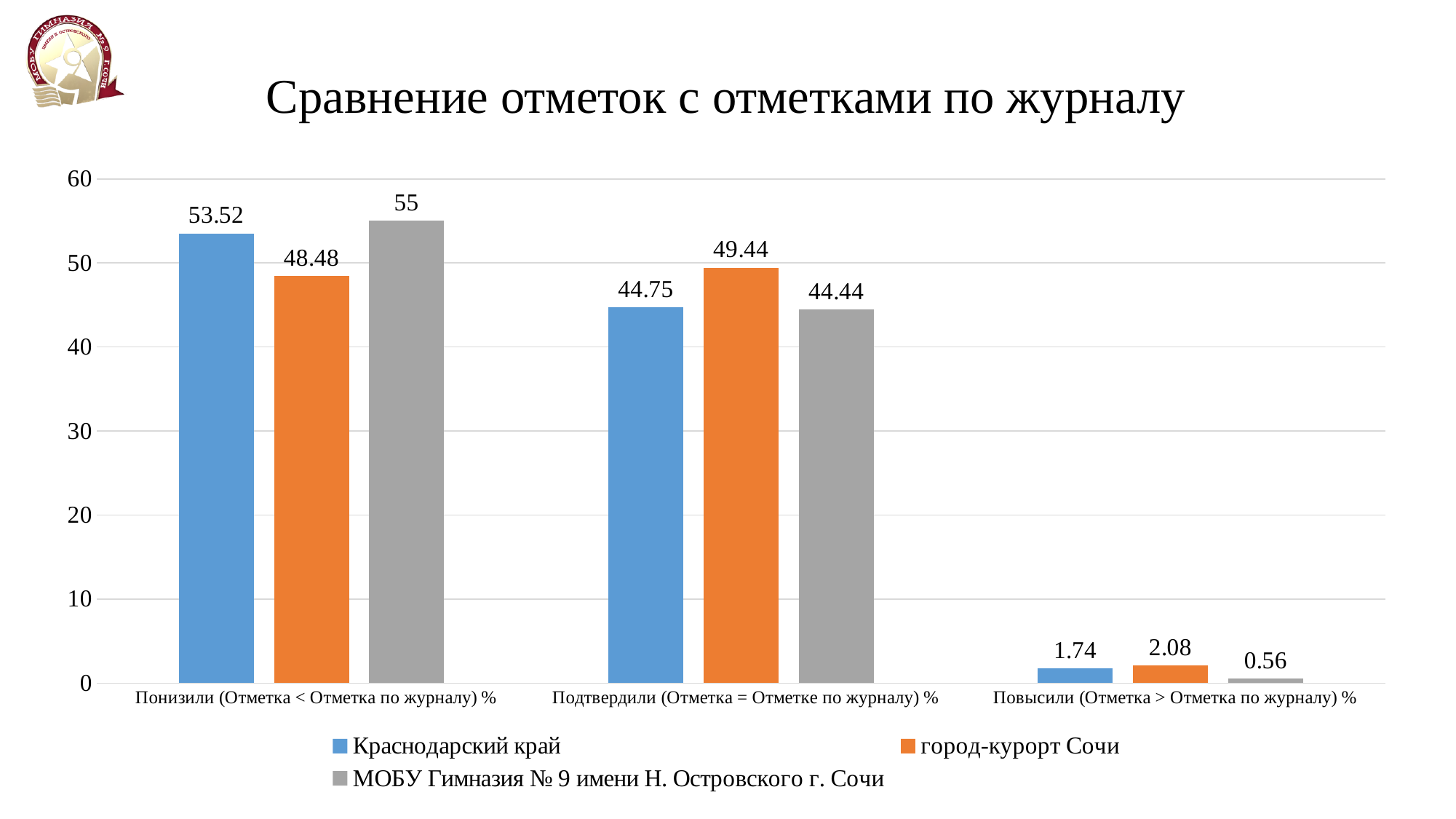
How many series does the legend list? 3 What kind of chart is shown on the slide? bar chart What is the title of the chart on the slide? Сравнение отметок с отметками по журналу Which series has the lowest value in the category Повысили (Отметка > Отметка по журналу) %? МОБУ Гимназия № 9 имени Н. Островского г. Сочи Which series has the highest value in the category Понизили (Отметка < Отметка по журналу) %? МОБУ Гимназия № 9 имени Н. Островского г. Сочи What is the value for МОБУ Гимназия № 9 имени Н. Островского г. Сочи in the category Повысили (Отметка > Отметка по журналу) %? 0.56 Which is larger in the category Подтвердили (Отметка = Отметке по журналу) %: the value for Краснодарский край or for город-курорт Сочи? город-курорт Сочи How many categories are shown on the x axis? 3 Is the value for Краснодарский край in the category Подтвердили (Отметка = Отметке по журналу) % greater or less than 50? less What is the difference between the values for МОБУ Гимназия № 9 имени Н. Островского г. Сочи and город-курорт Сочи in the category Понизили (Отметка < Отметка по журналу) %? 6.52 What is the value for город-курорт Сочи in the category Подтвердили (Отметка = Отметке по журналу) %? 49.44 What is the value for Краснодарский край in the category Понизили (Отметка < Отметка по журналу) %? 53.52